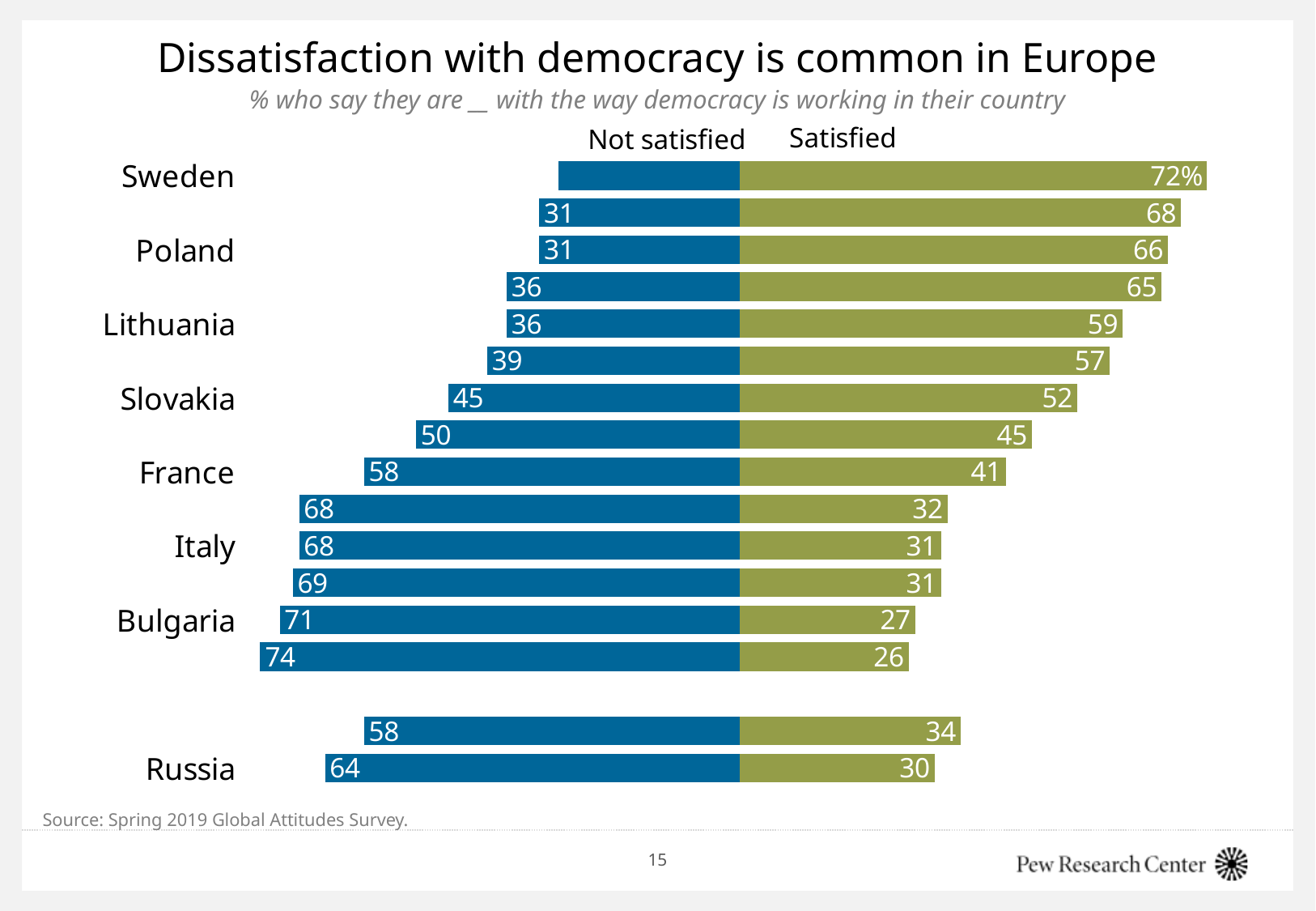
What is the difference between the 'Not satisfied' and 'Satisfied' values for Bulgaria? 44 What is the 'Not satisfied' value for Russia? 64 What percentage of people in Sweden say they are satisfied with the way democracy is working in their country? 72% What is the 'Satisfied' value for France? 41 Which has a larger 'Not satisfied' value, France or Italy? Italy Which country has the highest 'Satisfied' value? Sweden What is the 'Satisfied' value for Lithuania? 59 How many series does the legend list? 2 What is the 'Not satisfied' value for Poland? 31 What kind of chart is shown on the slide? Bar chart What is the 'Not satisfied' value for Slovakia? 45 What are the two legend entries shown above the bars? Not satisfied and Satisfied